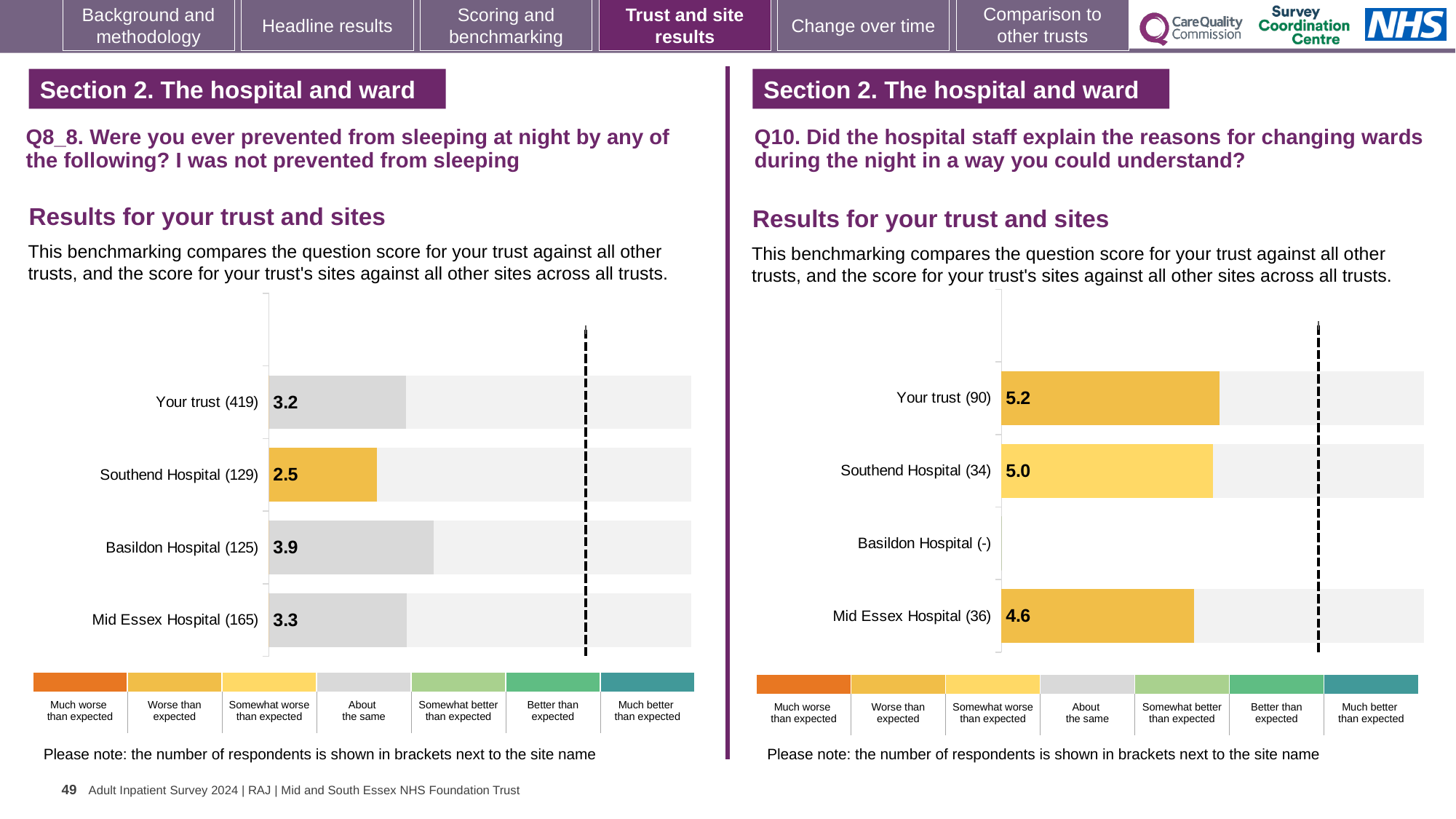
What type of chart is used on the left for Q8_8? Bar chart In the Q10 chart on the right, which is larger, the score for Southend Hospital or Mid Essex Hospital? Southend Hospital In the Q10 chart on the right, what is the score for Your trust? 5.2 In the Q10 chart on the right, what is the score for Mid Essex Hospital? 4.6 In the Q8_8 chart on the left, which site has the lowest score? Southend Hospital In the Q8_8 chart on the left, what is the score for Southend Hospital? 2.5 In the Q10 chart on the right, which site has no score shown? Basildon Hospital In the Q8_8 chart on the left, what is the score for Your trust? 3.2 In the Q8_8 chart on the left, which site has the highest score? Basildon Hospital In the Q10 chart on the right, what is the difference between the scores for Your trust and Mid Essex Hospital? 0.6 In the Q8_8 chart on the left, what is the difference between the scores for Basildon Hospital and Mid Essex Hospital? 0.6 In the Q8_8 chart on the left, how many respondents are shown for Mid Essex Hospital? 165